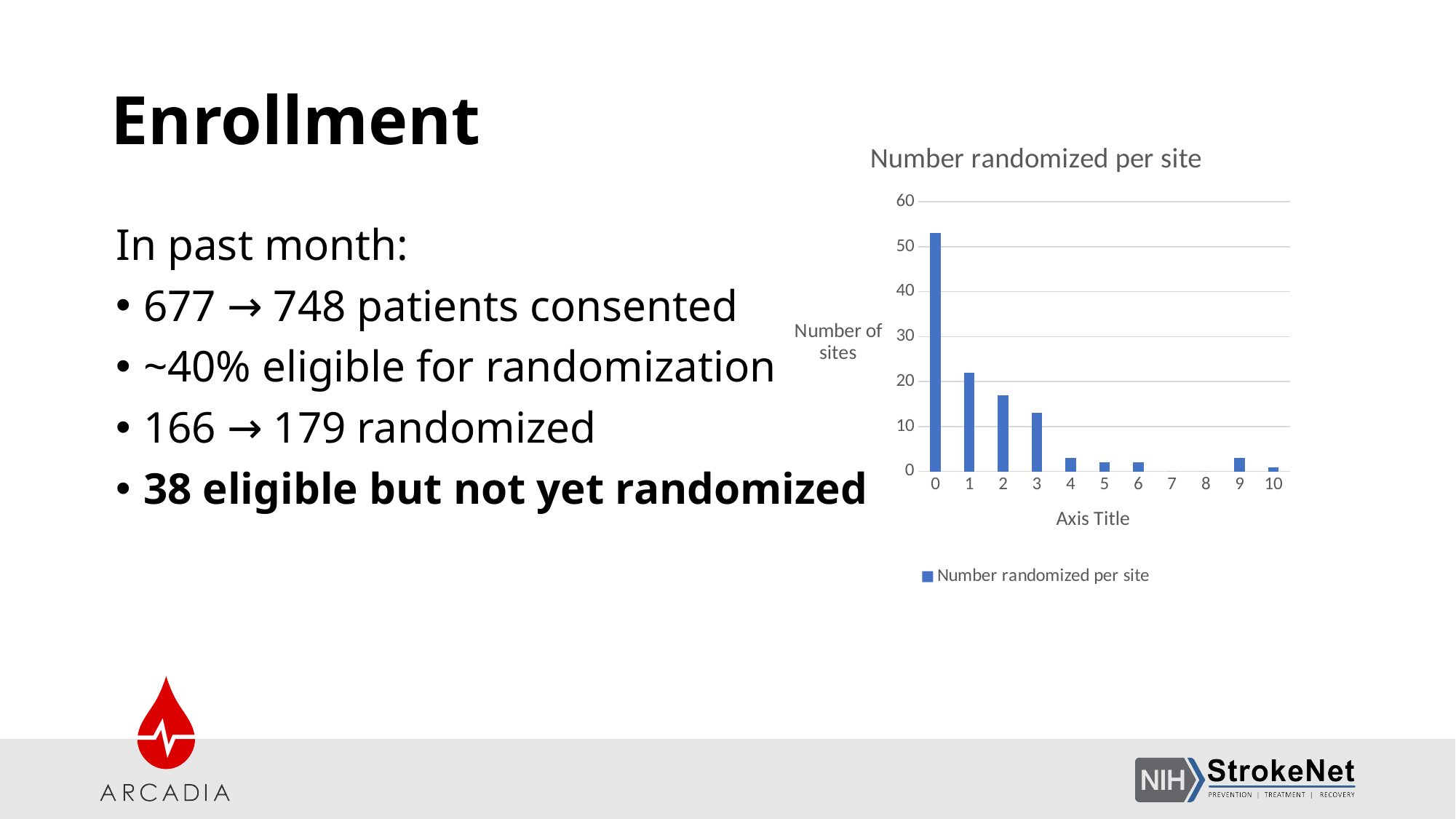
What is the title of the chart? Number randomized per site How many series does the chart's legend list? 1 What kind of chart is shown on the slide? bar chart Is the number of sites for category 2 greater or less than 20? less Is the number of sites for category 0 greater or less than 50? greater Which has more sites, category 3 or category 4? 3 Which has more sites, category 1 or category 2? 1 Is the number of sites for category 1 greater or less than 20? greater Which category has the highest number of sites? 0 How many categories are shown on the x axis of the chart? 11 Do the values generally rise or fall as you move from category 0 to category 10 along the x axis? fall